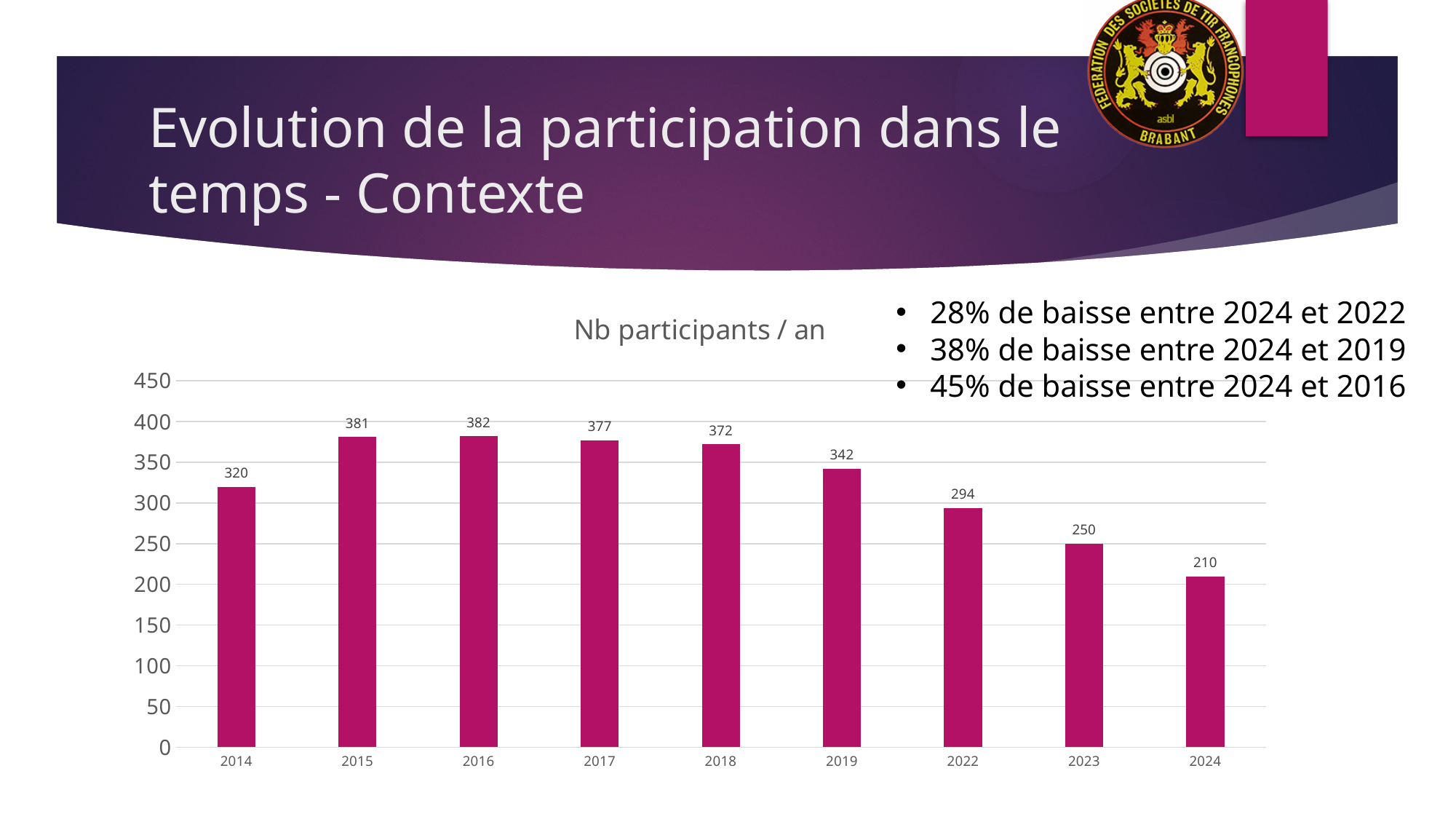
What is the number of participants in 2019? 342 What kind of chart is shown on the slide? Bar chart Which year has the lowest number of participants? 2024 What is the number of participants in 2014? 320 Which year has more participants, 2017 or 2023? 2017 Is the value for 2018 greater or less than 350? greater What is the number of participants in 2024? 210 What is the difference in participants between 2022 and 2024? 84 Which year has the highest number of participants? 2016 How many years are shown on the x axis? 9 What is the title of the chart? Nb participants / an Do the values rise or fall from 2016 to 2024? Fall